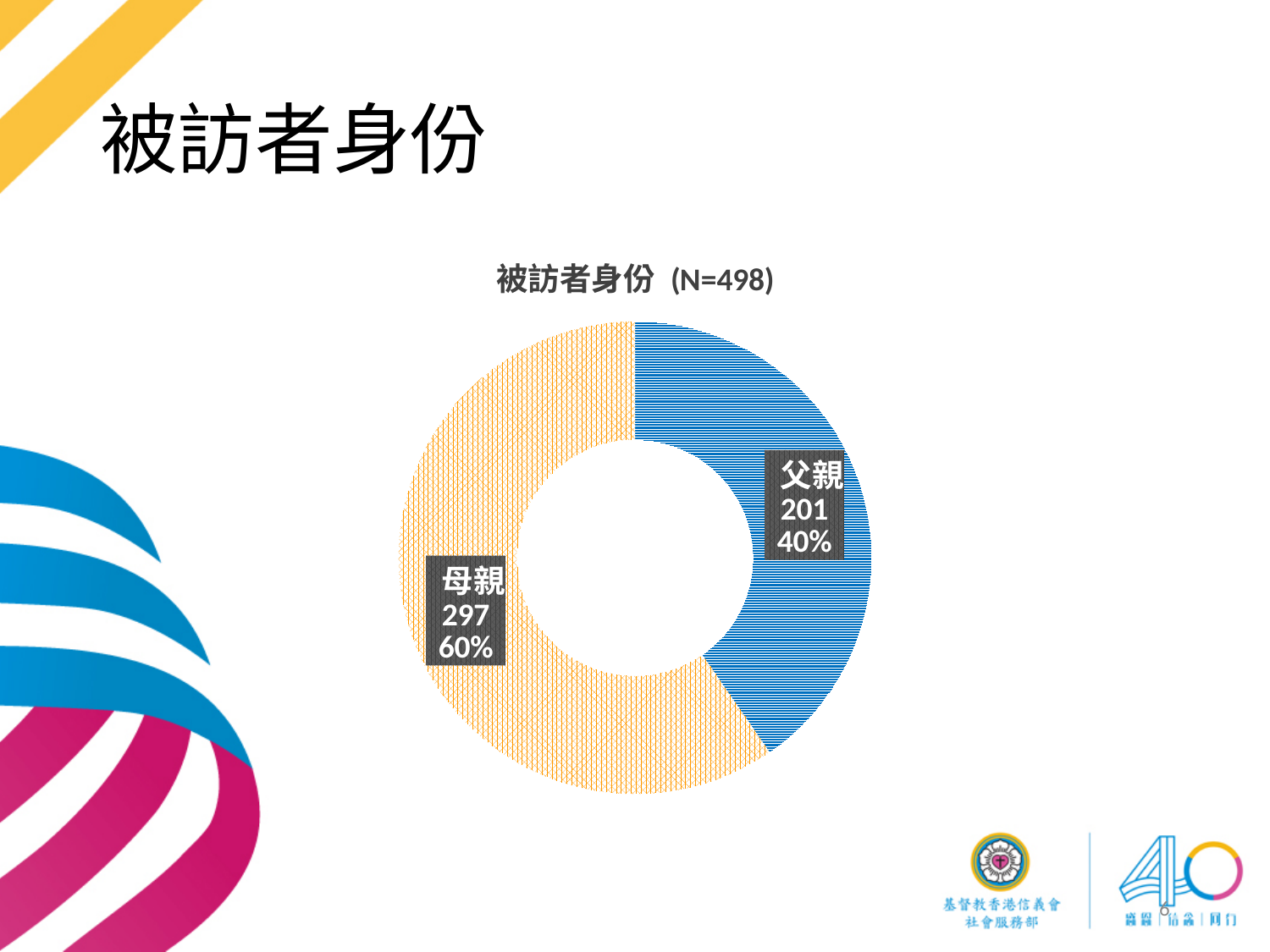
What is the total number of respondents (N) stated in the chart title? 498 What kind of chart is shown on the slide? Doughnut (pie) chart Is the count for 母親 larger or smaller than the count for 父親? larger Which category has the larger share of respondents? 母親 What is the count for 母親 in the chart? 297 What percentage of respondents are 母親? 60% What is the difference in count between 母親 and 父親? 96 Which category has the smaller share of respondents? 父親 What is the title of the chart? 被訪者身份 (N=498) What is the count for 父親 in the chart? 201 How many categories does the chart show? 2 What percentage of respondents are 父親? 40%